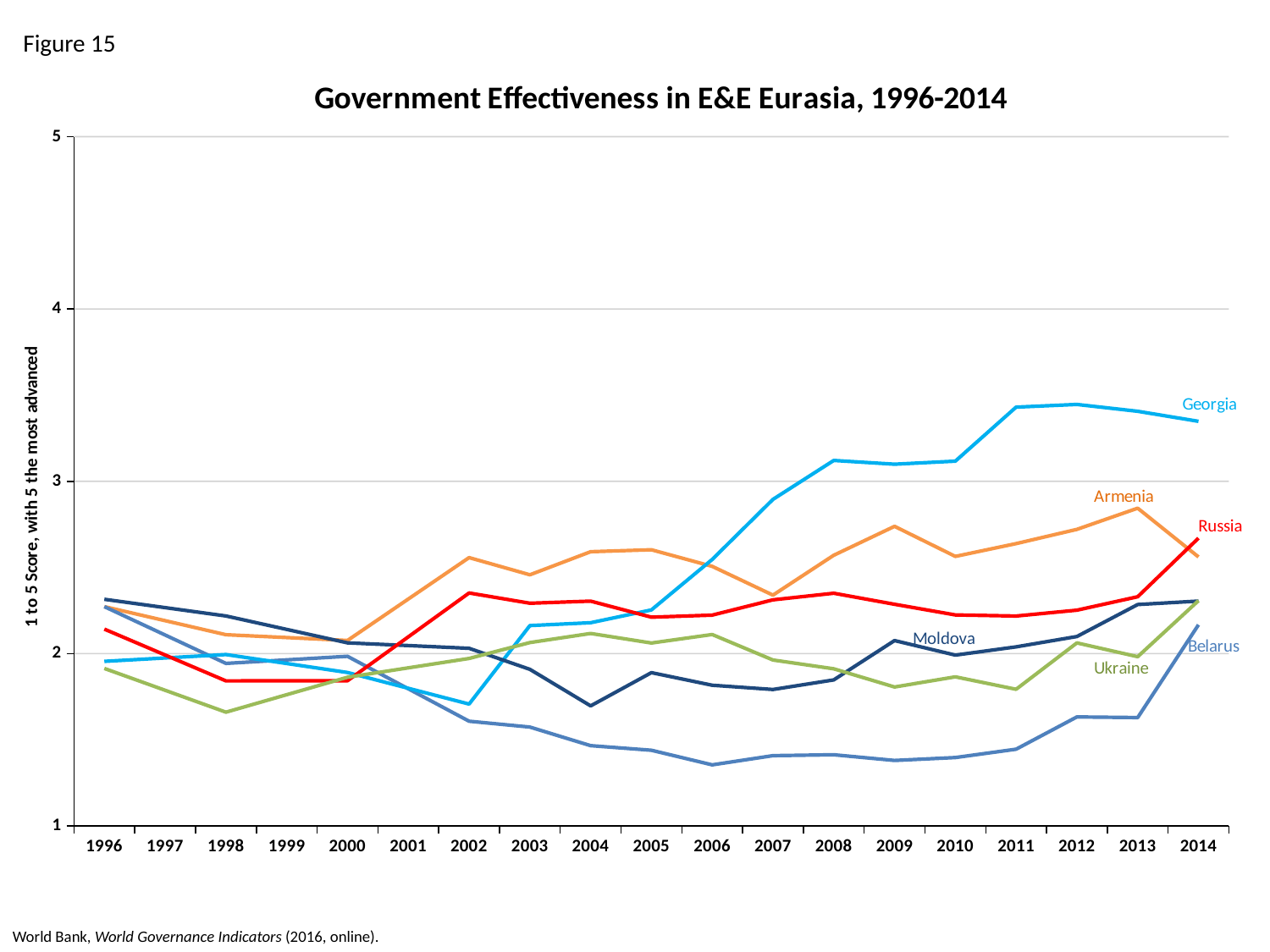
What is the label on the y axis? 1 to 5 Score, with 5 the most advanced In 2009, which country has the higher score, Armenia or Russia? Armenia How many countries are plotted as lines on the chart? 6 Which country has the lowest government effectiveness score in 2008? Belarus How many years are shown along the x axis? 19 What is the title of the chart? Government Effectiveness in E&E Eurasia, 1996-2014 Is the value for Armenia in 2013 greater or less than 3? less Is the value for Belarus in 2006 greater or less than 2? less What kind of chart is shown on the slide? line chart Which country has the highest government effectiveness score in 2014? Georgia Does Georgia's score rise or fall between 2002 and 2011? rise Is the value for Georgia in 2014 greater or less than 3? greater